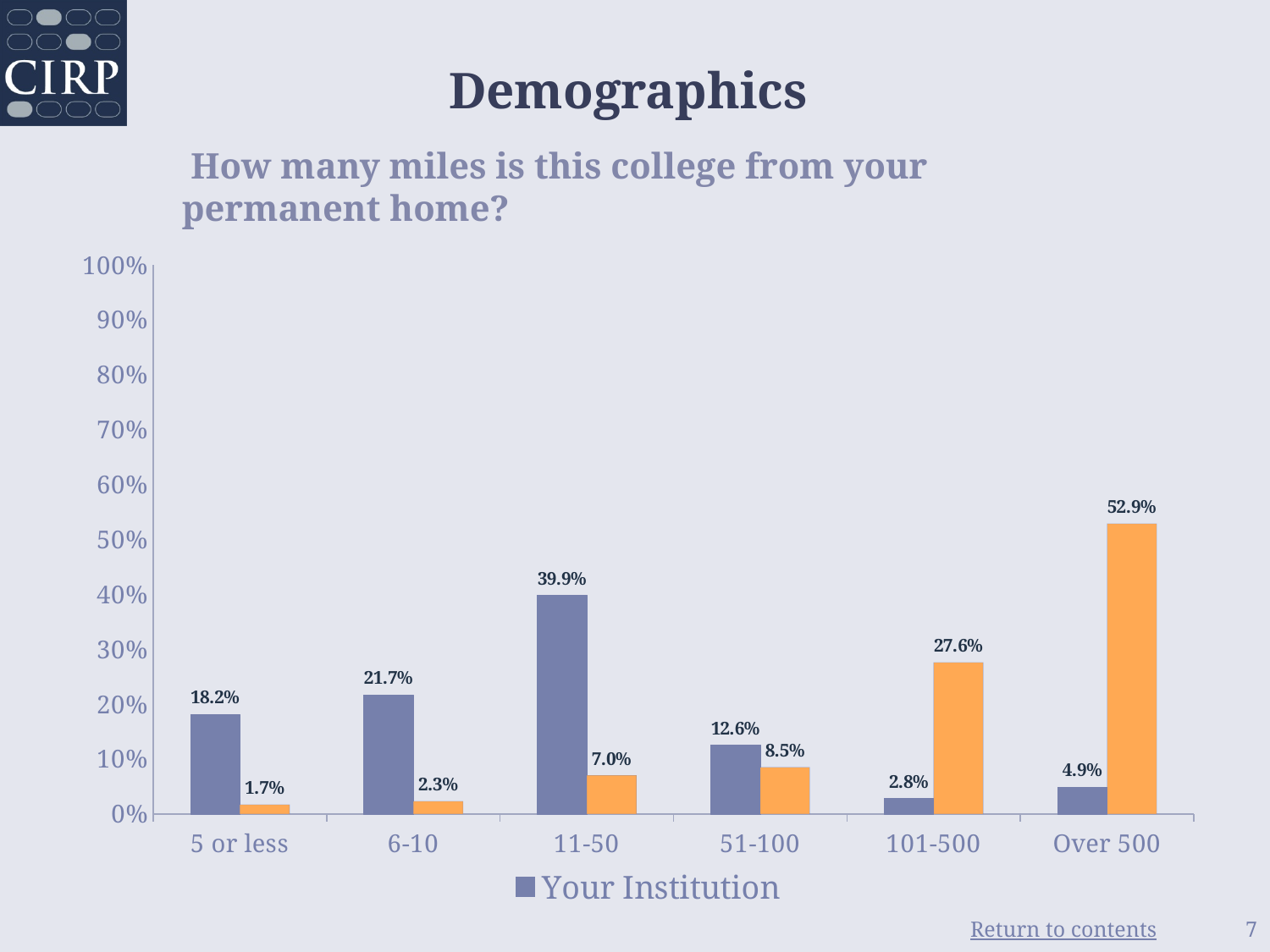
Which category has the lowest value for Your Institution? 101-500 Which category has the highest value for Your Institution? 11-50 What is the difference between the Your Institution values for 6-10 and 5 or less? 3.5% How many categories are shown on the x axis? 6 Is the value for Your Institution in the 11-50 category greater or less than 30%? greater For Your Institution, which is larger: the value for 5 or less or the value for Over 500? 5 or less What question does the chart title ask? How many miles is this college from your permanent home? What is the value of the orange bar in the Over 500 category? 52.9% What kind of chart is shown on the slide? bar chart What is the value for Your Institution in the 11-50 category? 39.9% How many series does the legend list? 1 What is the value for Your Institution in the 51-100 category? 12.6%